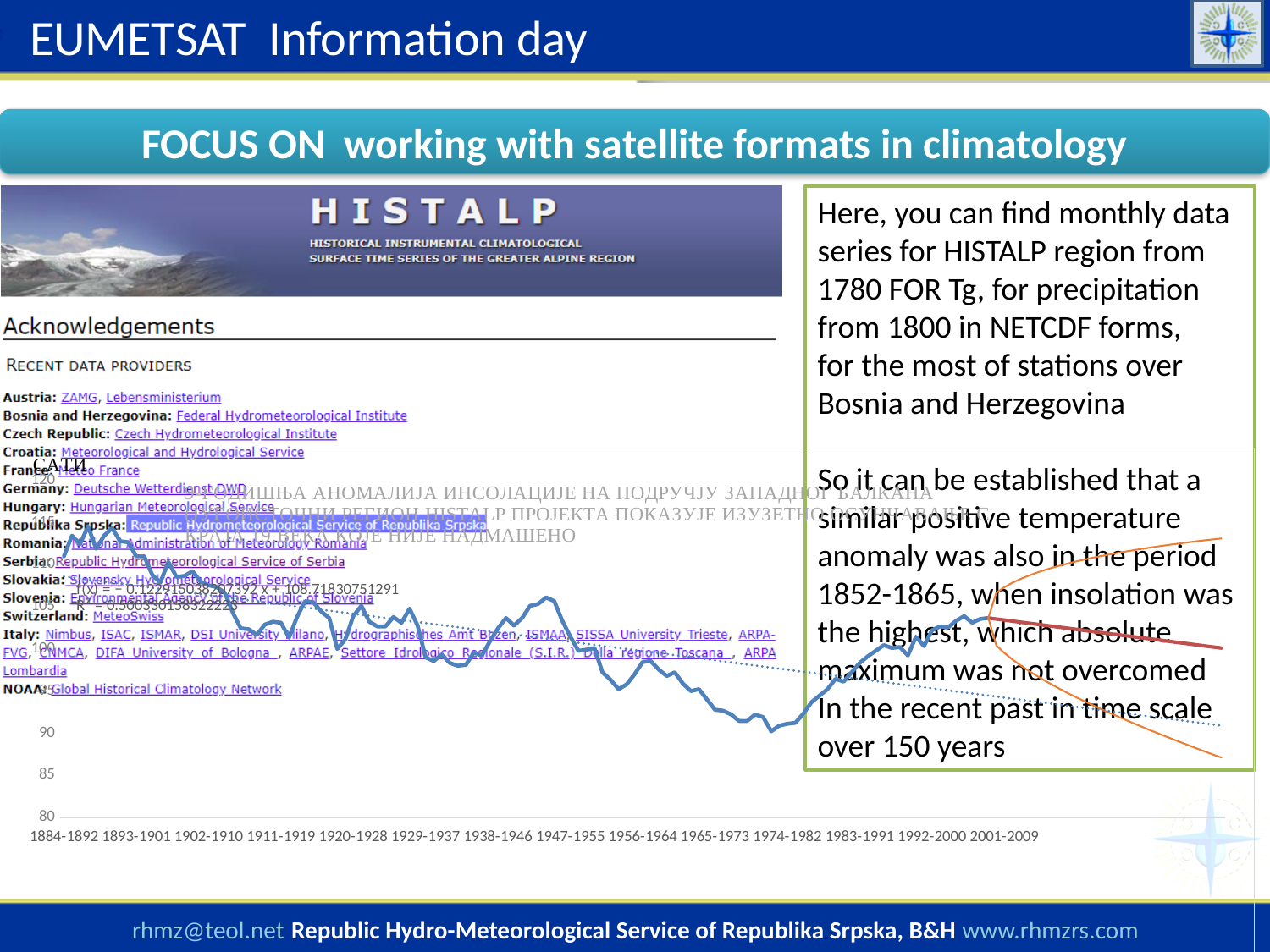
What kind of chart is shown on the slide? line chart Is the value for 1947-1955 greater or less than 90? greater Which has the larger value, 1884-1892 or 1992-2000? 1884-1892 Is the value for 1911-1919 greater or less than 90? greater Is the value for 1992-2000 greater or less than 100? greater What is the lowest value shown on the y axis of the chart? 80 How many periods are labelled along the x axis of the chart? 14 Do the values in the chart generally rise or fall from left to right along the x axis? fall What is the label of the first period on the x axis of the chart? 1884-1892